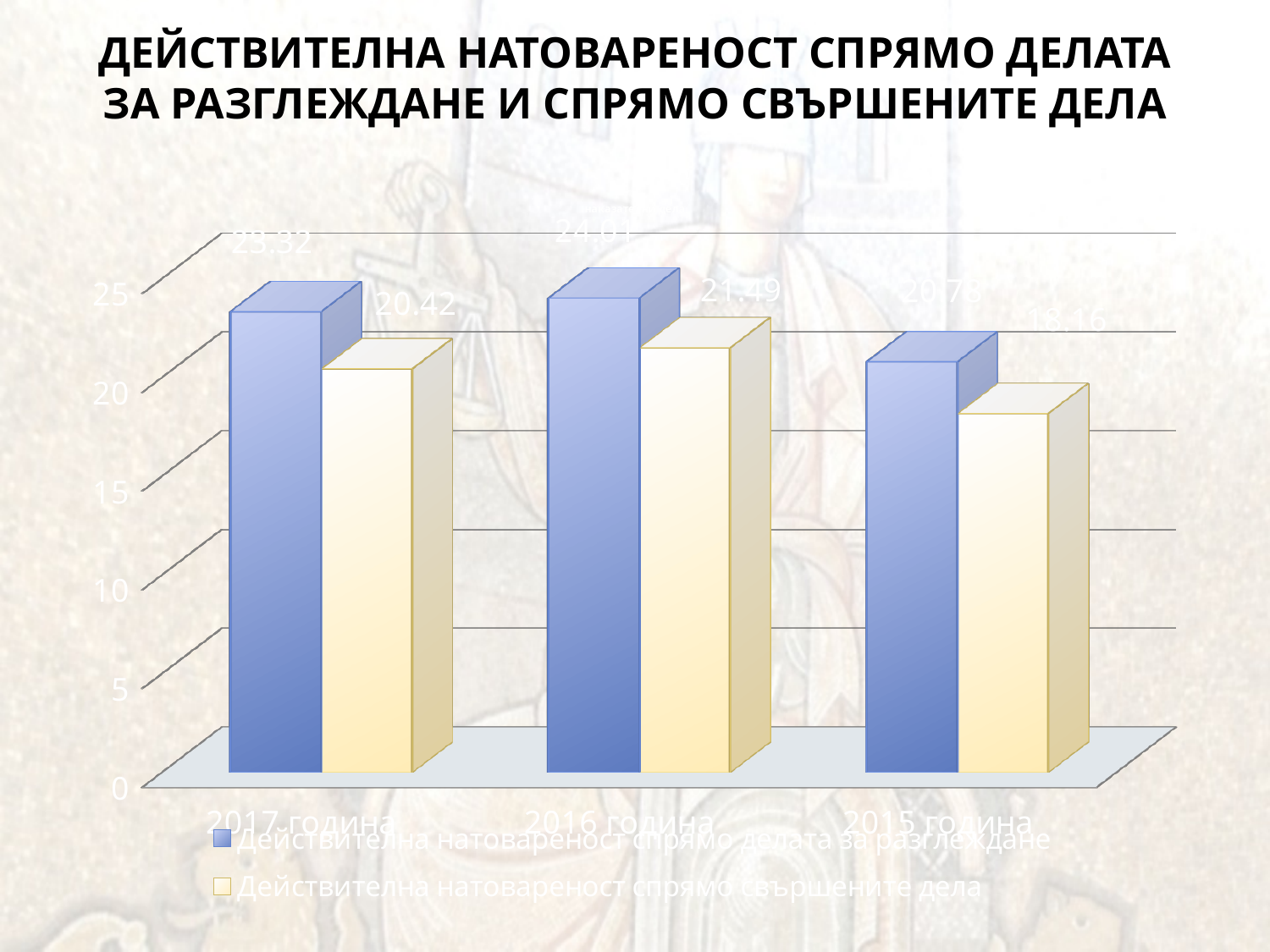
What is the value of 'Действителна натовареност спрямо делата за разглеждане' for 2015 година? 20.78 Which year has the highest value for 'Действителна натовареност спрямо делата за разглеждане'? 2016 година How many series does the legend list? 2 What is the value of 'Действителна натовареност спрямо свършените дела' for 2015 година? 18.16 What type of chart is shown on the slide? bar chart What is the value of 'Действителна натовареност спрямо свършените дела' for 2016 година? 21.49 Which year has the lowest value for 'Действителна натовареност спрямо свършените дела'? 2015 година How many year categories are shown on the x axis? 3 Is the value for 'Действителна натовареност спрямо свършените дела' in 2015 година greater or less than 20? less What is the value of 'Действителна натовареност спрямо делата за разглеждане' for 2017 година? 23.32 What is the difference between the two series' values for 2017 година? 2.9 What is the value of 'Действителна натовареност спрямо свършените дела' for 2017 година? 20.42